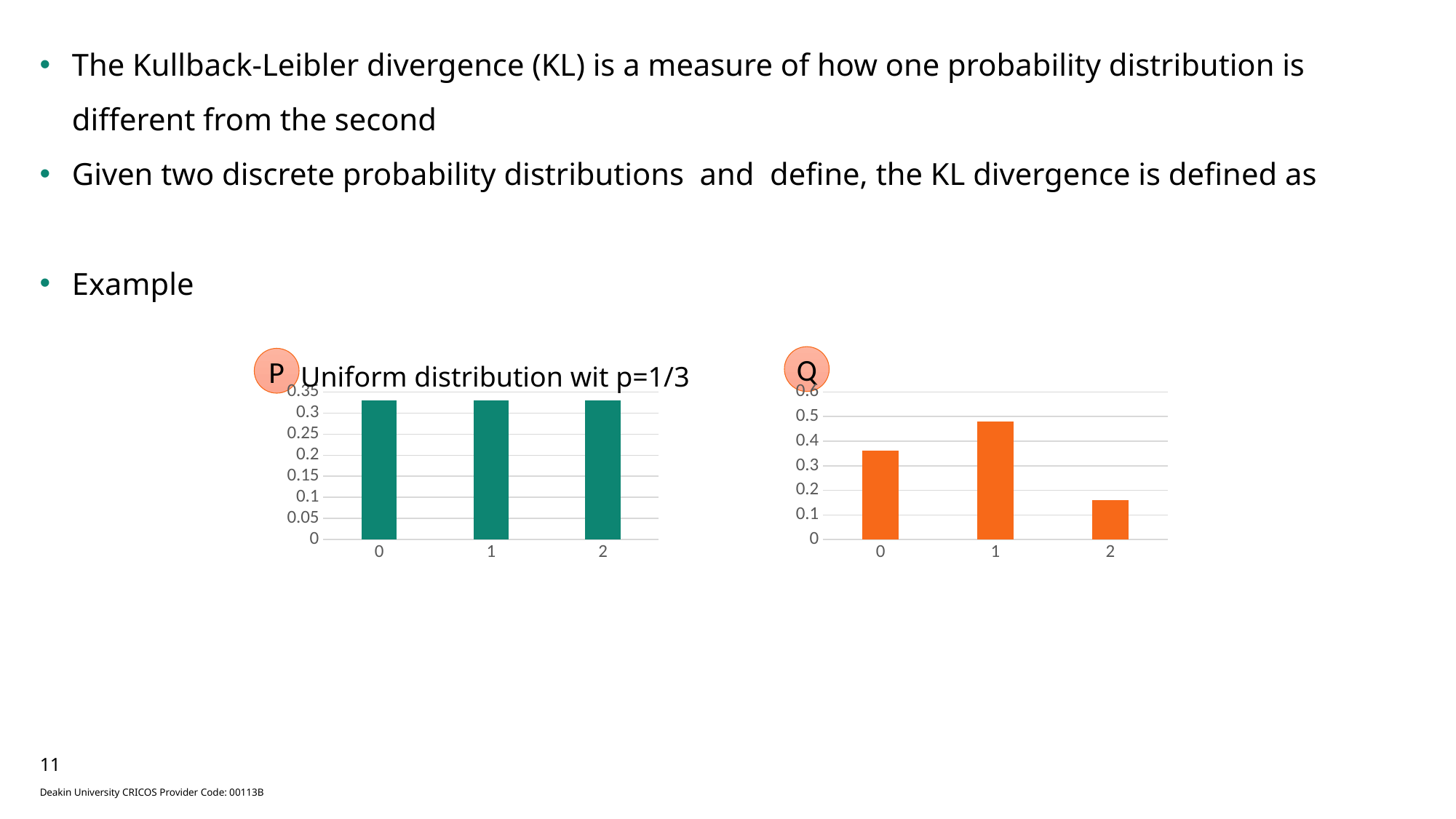
What is the title of the left chart labelled P? Uniform distribution wit p=1/3 In the right chart labelled Q, is the value for category 0 greater or less than 0.3? greater What kind of chart is the left chart labelled P? bar chart In the right chart labelled Q, which category has the lowest bar? 2 In the right chart labelled Q, which is larger, the value for category 0 or the value for category 2? 0 In the left chart labelled P, how many categories are shown on the x axis? 3 In the right chart labelled Q, is the value for category 2 greater or less than 0.2? less In the left chart labelled P, is the value for category 2 greater or less than 0.3? greater In the right chart labelled Q, how many bars are plotted? 3 In the right chart labelled Q, which category has the highest bar? 1